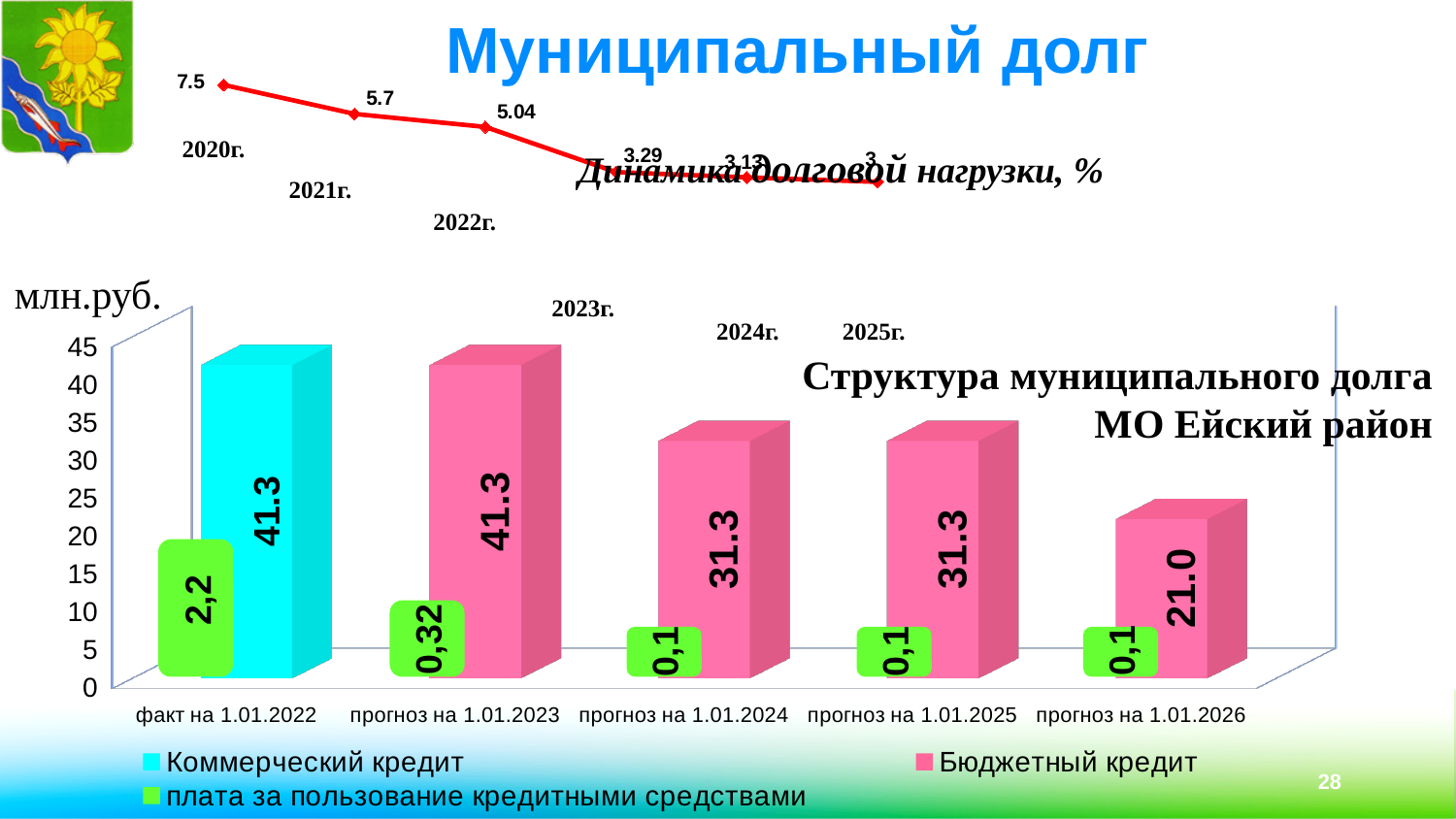
On the bar chart 'Структура муниципального долга МО Ейский район', what is the value of Бюджетный кредит for прогноз на 1.01.2024? 31.3 On the line chart 'Динамика долговой нагрузки, %', what is the value for 2020г.? 7.5 On the line chart 'Динамика долговой нагрузки, %', what is the value for 2022г.? 5.04 On the line chart 'Динамика долговой нагрузки, %', how many years are plotted? 6 What kind of chart is 'Структура муниципального долга МО Ейский район'? bar chart On the bar chart 'Структура муниципального долга МО Ейский район', which is larger: Бюджетный кредит for прогноз на 1.01.2023 or for прогноз на 1.01.2026? прогноз на 1.01.2023 On the bar chart 'Структура муниципального долга МО Ейский район', how many series does the legend list? 3 On the bar chart 'Структура муниципального долга МО Ейский район', what is the value of Бюджетный кредит for прогноз на 1.01.2026? 21.0 On the line chart 'Динамика долговой нагрузки, %', do the values rise or fall from 2020г. to 2025г.? fall On the line chart 'Динамика долговой нагрузки, %', what is the difference between the values for 2020г. and 2021г.? 1.8 On the line chart 'Динамика долговой нагрузки, %', which year has the highest value? 2020г. On the bar chart 'Структура муниципального долга МО Ейский район', what is the value of плата за пользование кредитными средствами for факт на 1.01.2022? 2,2